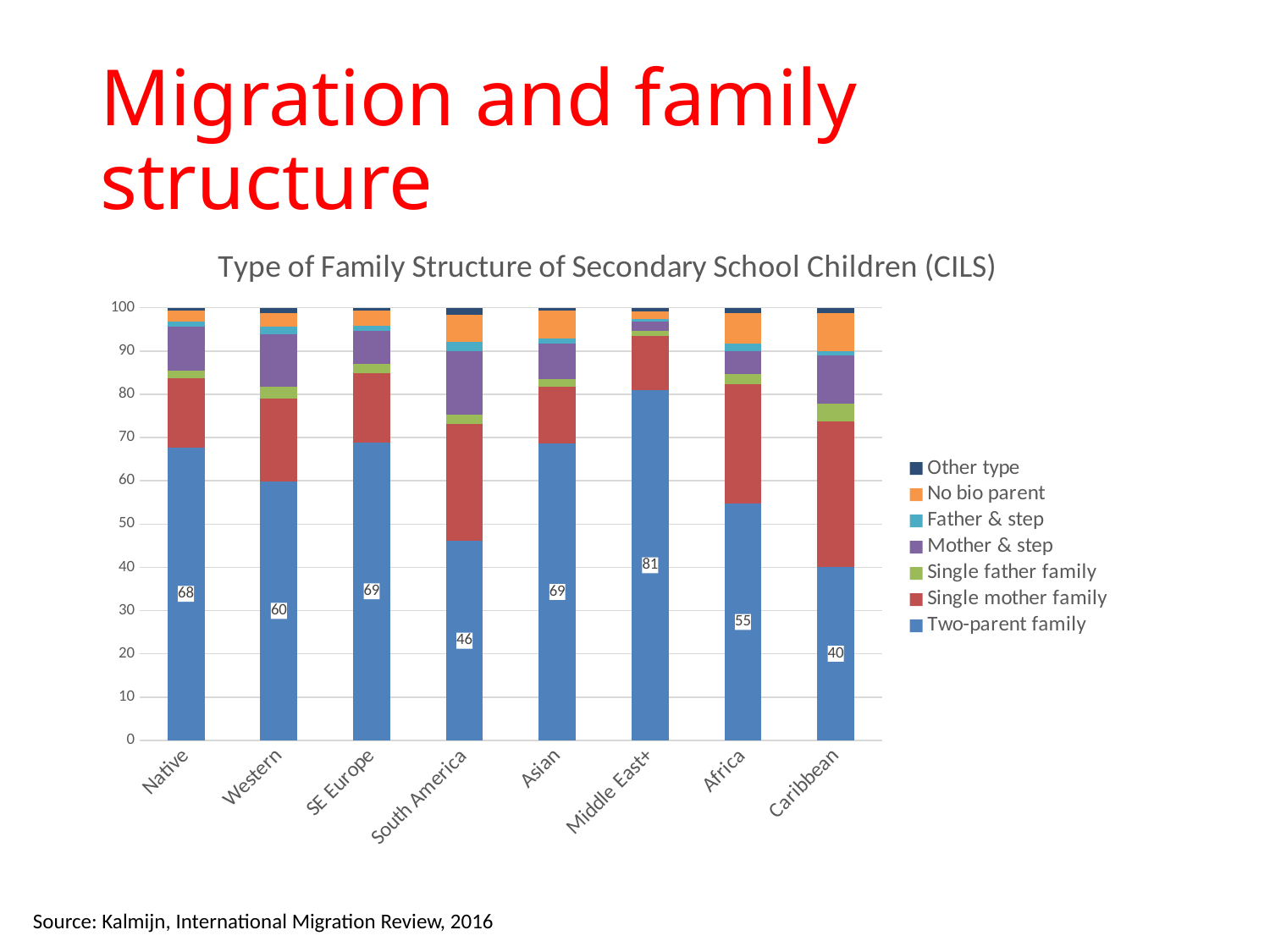
Which has a larger Two-parent family value, Western or Africa? Western What is the difference between the Two-parent family values for Middle East+ and Caribbean? 41 What is the Two-parent family value for South America? 46 Is the Two-parent family value for Asian greater or less than 60? greater What is the Two-parent family value for Caribbean? 40 What type of chart is shown on the slide? Stacked bar chart How many categories are shown on the x axis? 8 What is the title of the chart? Type of Family Structure of Secondary School Children (CILS) Which category has the lowest Two-parent family value? Caribbean Which category has the highest Two-parent family value? Middle East+ What is the Two-parent family value for Middle East+? 81 How many series does the legend list? 7